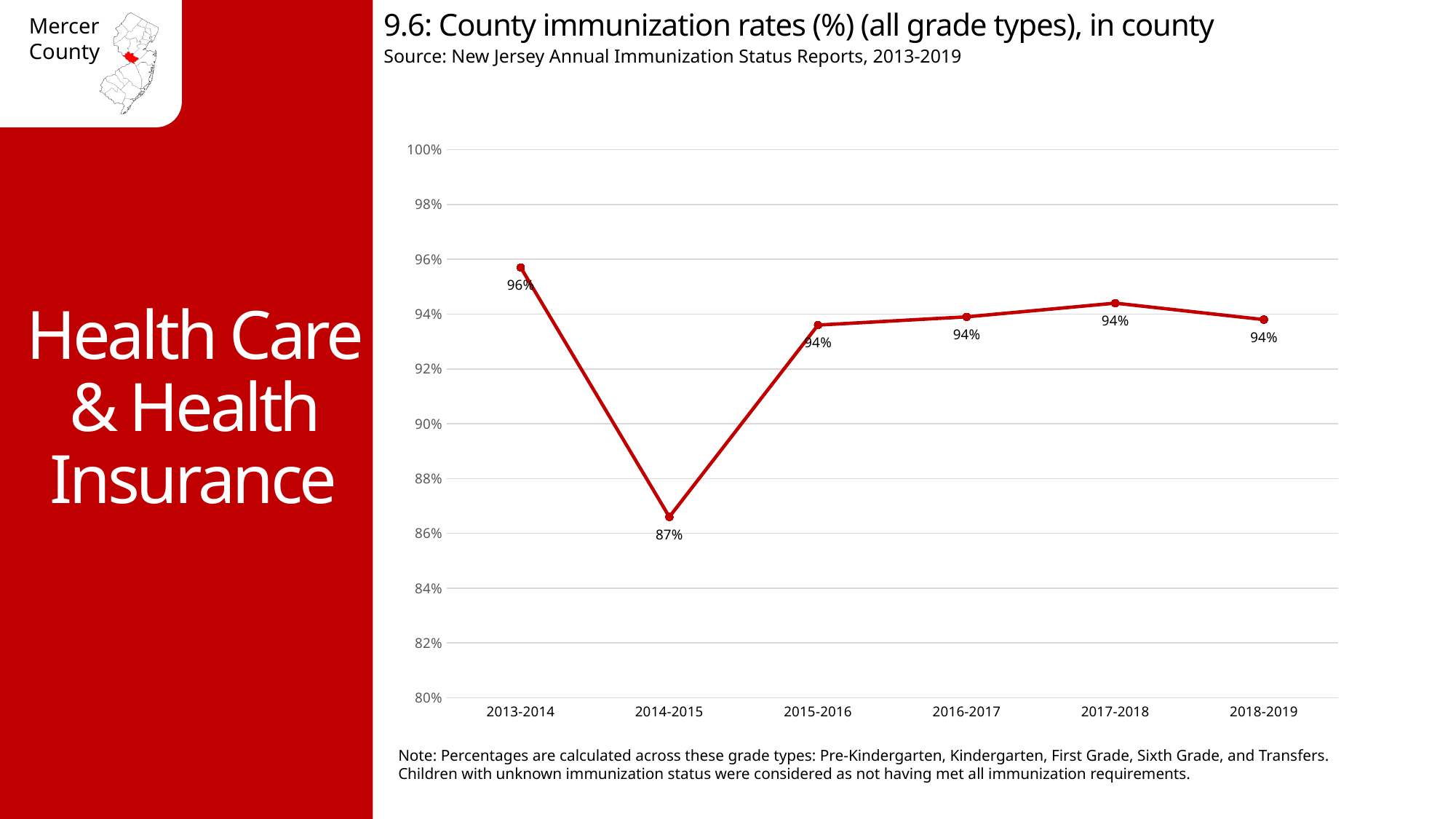
Does the immunization rate rise or fall from 2013-2014 to 2014-2015? Fall By how many percentage points does the 2013-2014 rate exceed the 2014-2015 rate? 9 percentage points Is the value for 2017-2018 greater or less than 92%? greater What is the county immunization rate for 2018-2019? 94% Which school year has the lowest immunization rate? 2014-2015 What is the county immunization rate for 2014-2015? 87% Is the value for 2014-2015 greater or less than 90%? less What is the county immunization rate for 2013-2014? 96% Which is larger, the immunization rate for 2014-2015 or for 2015-2016? 2015-2016 Which school year has the highest immunization rate? 2013-2014 How many school years are plotted on the chart? 6 What kind of chart is shown on the slide? Line chart